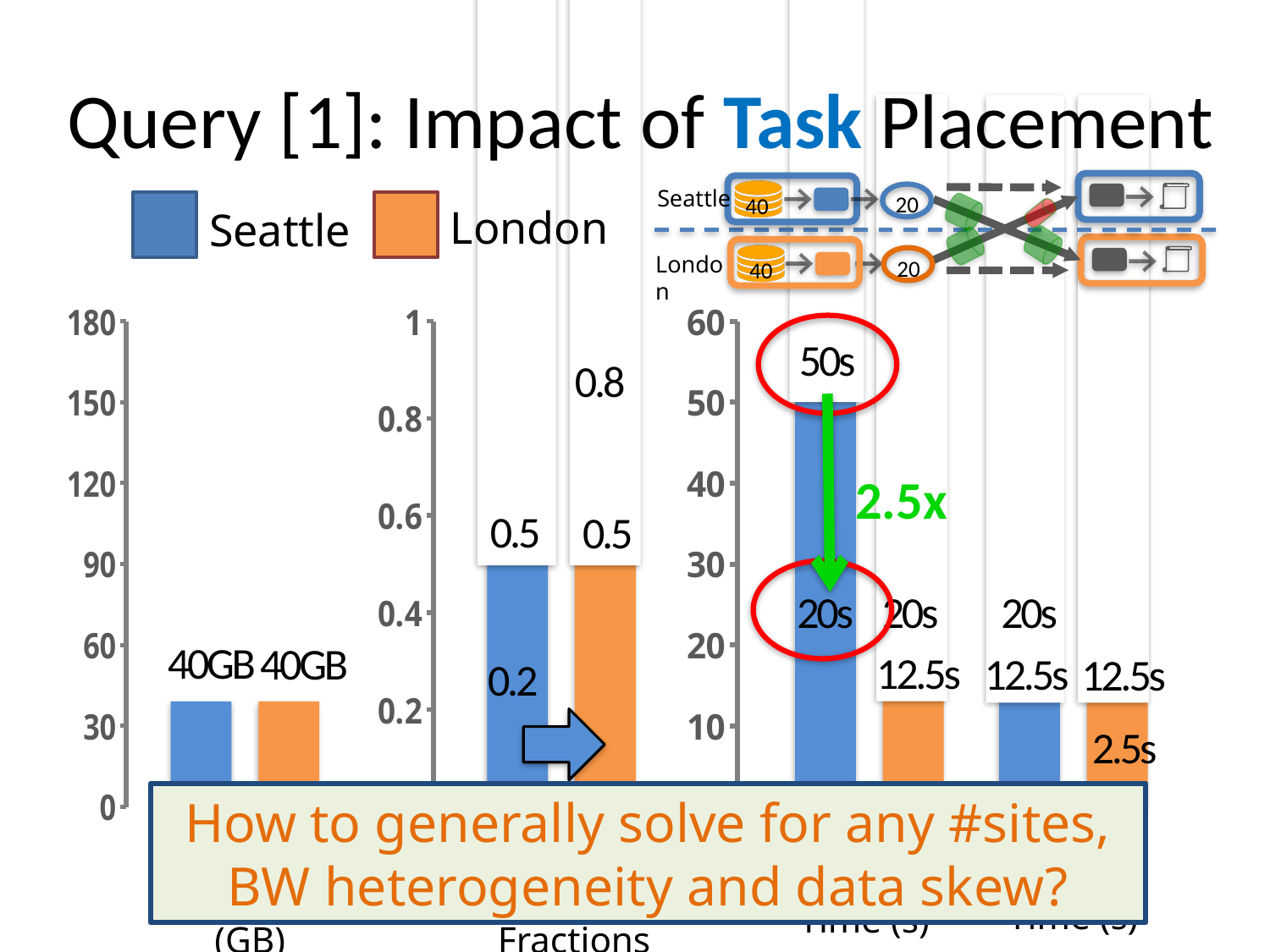
In the third chart from the left (time, axis 0-60), what is the value printed on the tall Seattle bar? 50s In the third chart from the left (time, axis 0-60), is the London bar greater or less than 20? less In the third chart from the left (time, axis 0-60), is the Seattle bar greater or less than 40? greater How many series does the legend list? 2 In the leftmost chart (GB), what is the value for Seattle? 40GB What speed-up factor is annotated in green on the time chart? 2.5x Which colour represents London in the legend? Orange What kind of chart is the leftmost chart (GB)? Bar chart In the third chart from the left (time, axis 0-60), which bar is taller, Seattle or London? Seattle In the leftmost chart (GB), is the value for Seattle greater or less than 60? less In the leftmost chart (GB), what is the value for London? 40GB In the leftmost chart (GB), how many bars are plotted? 2